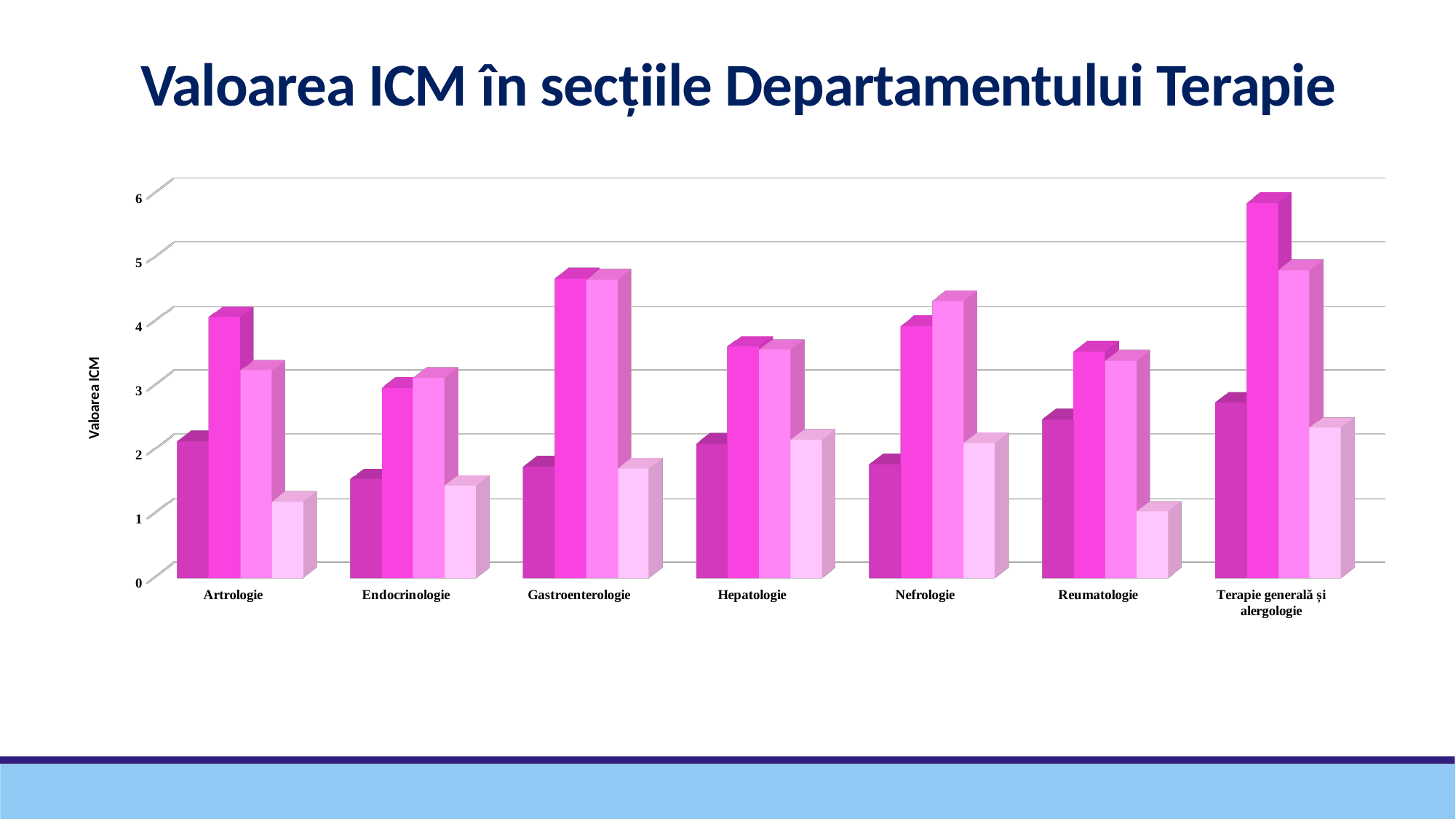
Is the value of the first bar for Gastroenterologie greater or less than 2? less What is the title of the chart? Valoarea ICM în secțiile Departamentului Terapie Which is larger: the second bar for Gastroenterologie or the second bar for Hepatologie? Gastroenterologie What is the label on the vertical axis of the chart? Valoarea ICM What kind of chart is shown on the slide? bar chart Which is larger: the second bar for Terapie generală și alergologie or the second bar for Artrologie? Terapie generală și alergologie Is the value of the second bar for Gastroenterologie greater or less than 4? greater Is the value of the second bar for Hepatologie greater or less than 4? less How many categories (sections) are shown along the x axis? 7 Which category contains the tallest bar in the chart? Terapie generală și alergologie How many bars are plotted for each category? 4